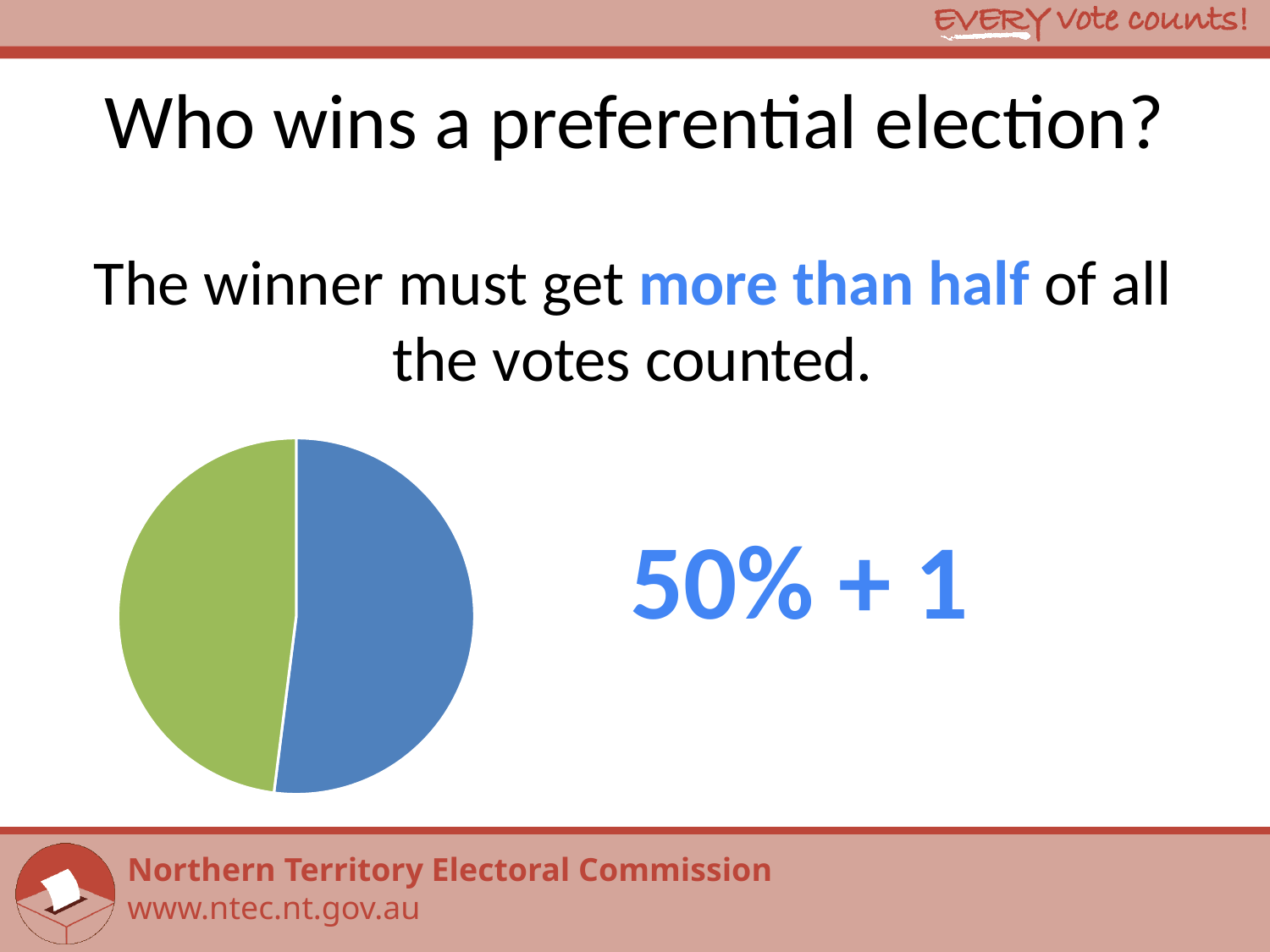
Does the pie chart have a legend? No How many slices does the pie chart have? 2 Which slice of the pie chart is larger, the blue one or the green one? blue What colours are the two slices of the pie chart? blue and green Does the pie chart show any data labels on its slices? No What kind of chart is shown on the slide? pie chart